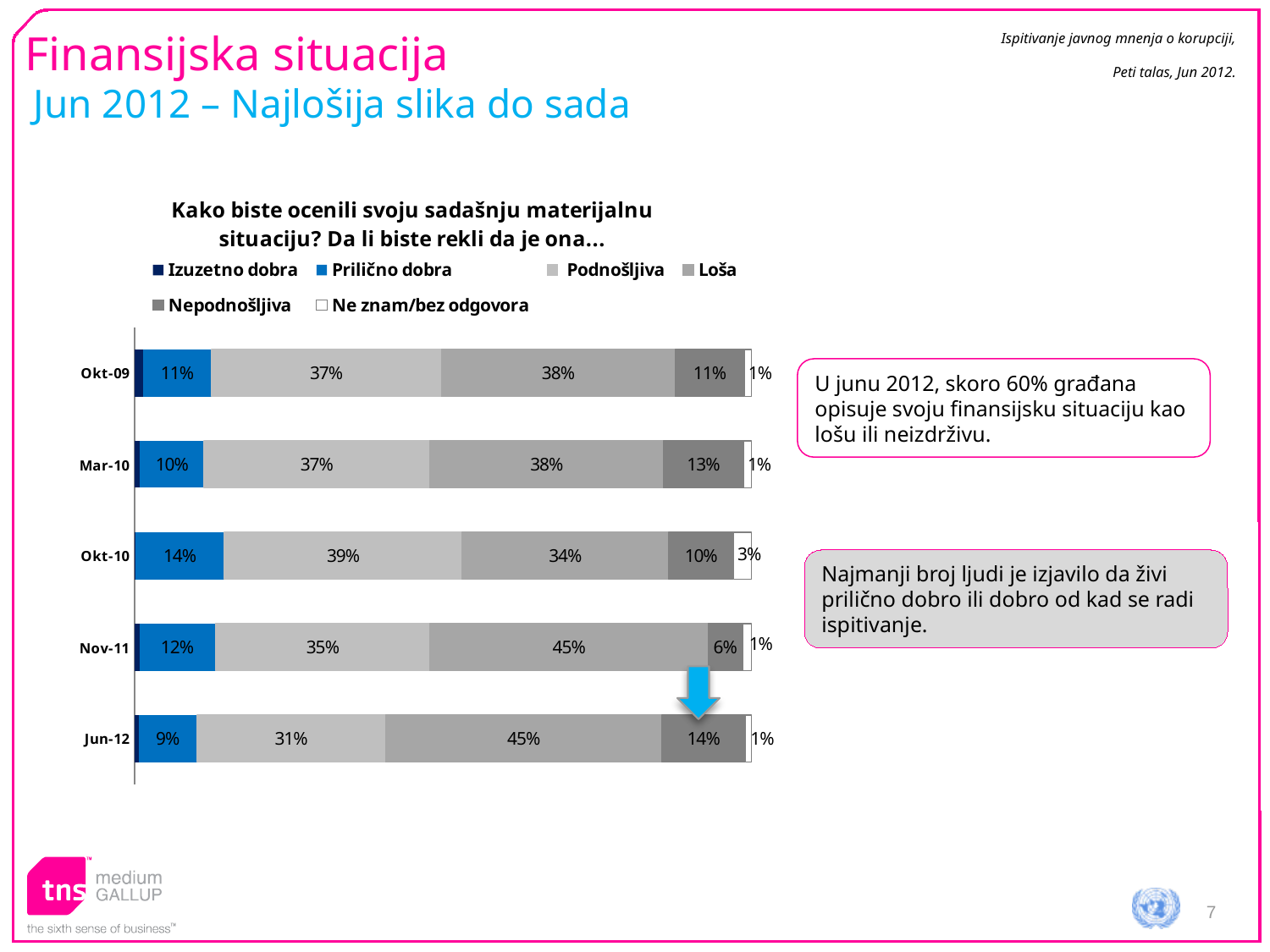
What is the value for 'Ne znam/bez odgovora' in Okt-10? 3% Is the 'Loša' value larger in Okt-10 or in Nov-11? Nov-11 Which survey wave has the highest value for 'Podnošljiva'? Okt-10 What is the value for 'Prilično dobra' in Okt-10? 14% How many series does the chart legend list? 6 What is the difference between the 'Nepodnošljiva' values for Jun-12 and Nov-11? 8% What kind of chart is shown on the slide? Stacked bar chart What is the value for 'Loša' in Jun-12? 45% What is the value for 'Nepodnošljiva' in Nov-11? 6% Which survey wave has the lowest value for 'Prilično dobra'? Jun-12 Which series is shown in the lightest grey colour in the legend? Podnošljiva How many survey waves (categories) are plotted on the chart? 5